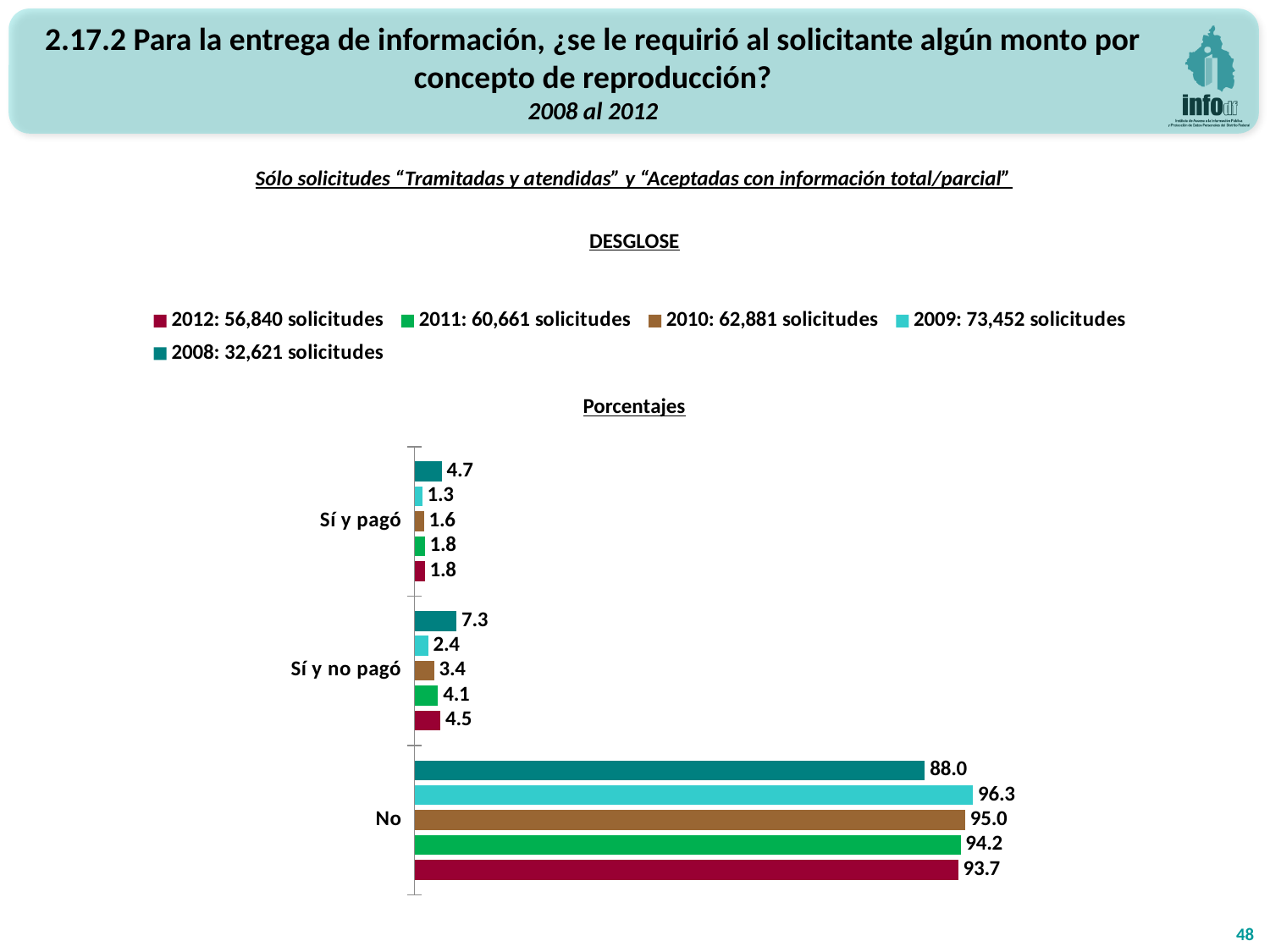
How many series does the legend list? 5 What is the difference between the 'No' percentages for 2009 and 2008? 8.3 Which is larger for 'Sí y no pagó': the 2010 value or the 2011 value? 2011 Which year has the highest percentage for 'No'? 2009 What is the difference between the 'Sí y no pagó' percentages for 2008 and 2009? 4.9 Which year has the lowest percentage for 'Sí y pagó'? 2009 According to the legend, how many solicitudes were there in 2010? 62,881 How many categories are shown on the chart? 3 What is the percentage for 'Sí y no pagó' in 2012? 4.5 What is the percentage for 'No' in 2009? 96.3 What kind of chart is shown on the slide? bar chart What is the percentage for 'Sí y pagó' in 2008? 4.7